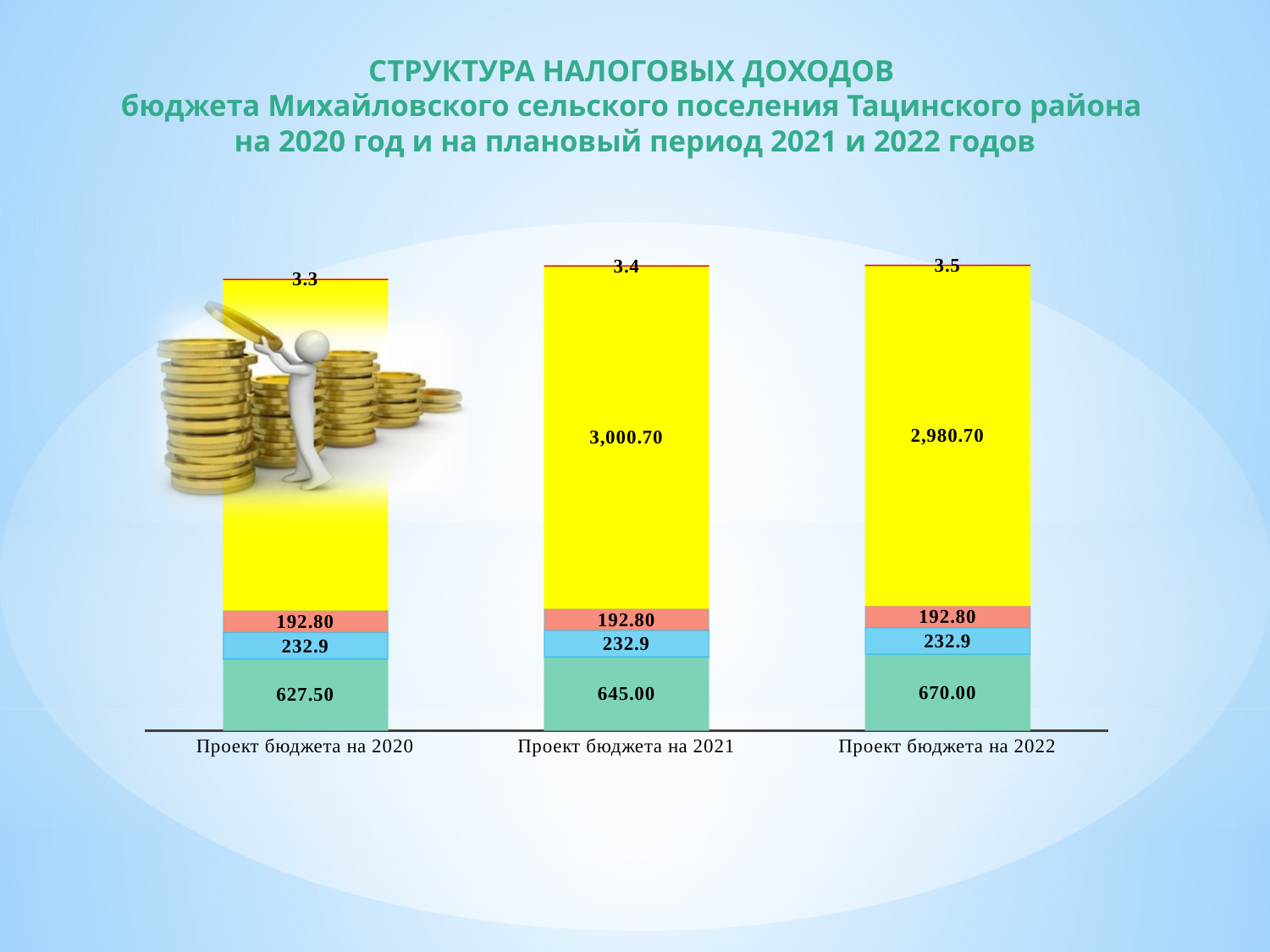
Which category has the highest value for the green bottom segment? Проект бюджета на 2022 What is the value labelled at the top of the bar for Проект бюджета на 2020? 3.3 Do the green bottom segment values rise or fall from 2020 to 2022? rise Which has the larger yellow segment value, Проект бюджета на 2021 or Проект бюджета на 2022? Проект бюджета на 2021 What is the value of the blue segment for Проект бюджета на 2021? 232.9 What is the value of the yellow segment for Проект бюджета на 2021? 3,000.70 What is the value of the green bottom segment for Проект бюджета на 2020? 627.50 What is the difference between the green segment values for Проект бюджета на 2022 and Проект бюджета на 2020? 42.50 What is the value of the yellow segment for Проект бюджета на 2022? 2,980.70 How many budget project categories are shown along the x axis? 3 What is the value of the green bottom segment for Проект бюджета на 2022? 670.00 What kind of chart is shown on the slide? stacked bar chart